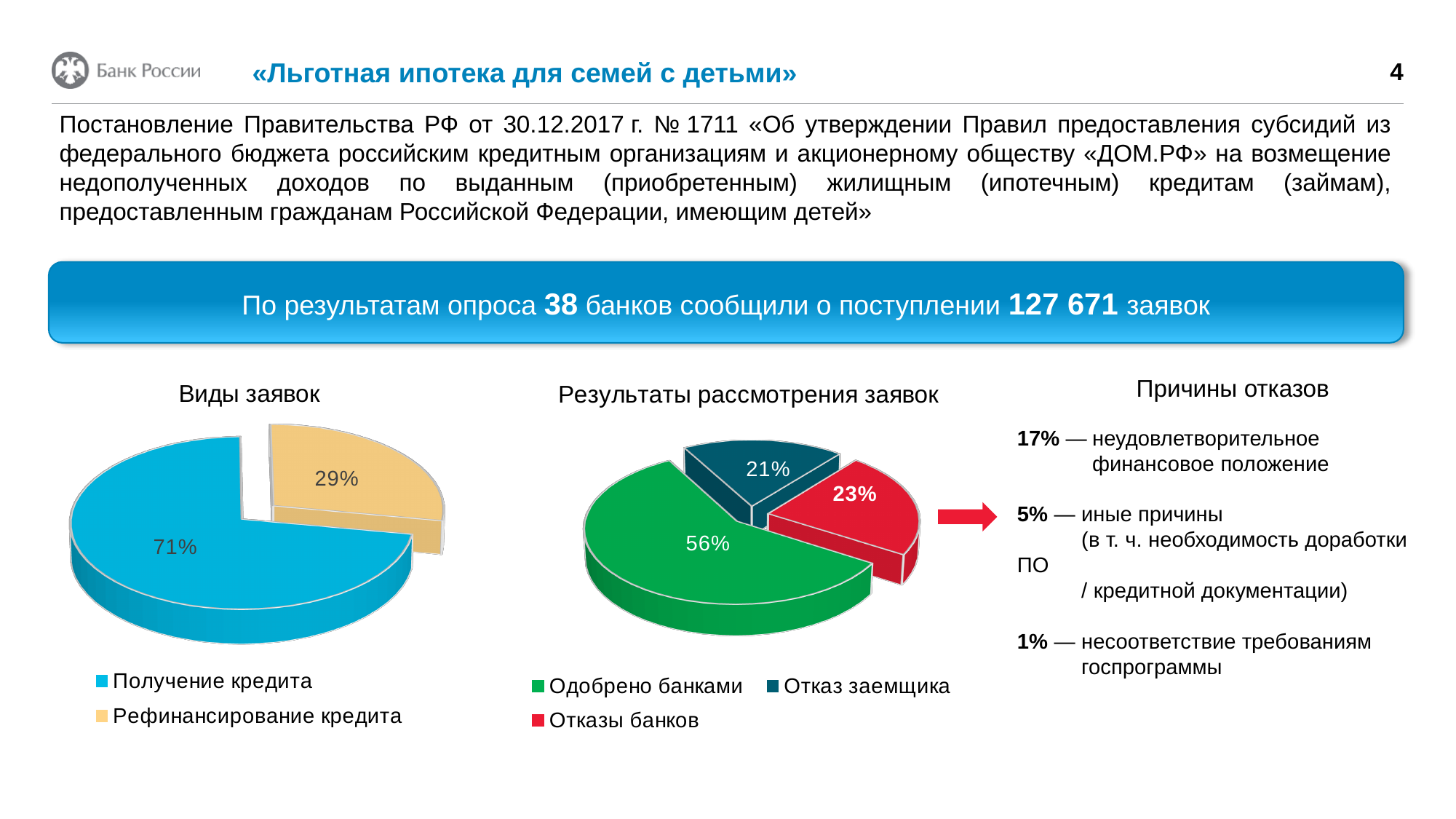
In the 'Результаты рассмотрения заявок' chart, what share is 'Отказ заемщика'? 21% In the 'Виды заявок' chart, what share is 'Получение кредита'? 71% How many categories does the 'Результаты рассмотрения заявок' chart show? 3 In the 'Виды заявок' chart, what colour is the 'Рефинансирование кредита' slice? Yellow (beige) In the 'Результаты рассмотрения заявок' chart, what share is 'Одобрено банками'? 56% In the 'Результаты рассмотрения заявок' chart, which category has the smallest share? Отказ заемщика In the 'Виды заявок' chart, what share is 'Рефинансирование кредита'? 29% In the 'Результаты рассмотрения заявок' chart, which category has the largest share? Одобрено банками In the 'Результаты рассмотрения заявок' chart, which is larger: 'Отказы банков' or 'Отказ заемщика'? Отказы банков What type of chart is 'Виды заявок'? Pie chart In the 'Результаты рассмотрения заявок' chart, what share is 'Отказы банков'? 23% In the 'Виды заявок' chart, what is the difference between the shares of 'Получение кредита' and 'Рефинансирование кредита'? 42%